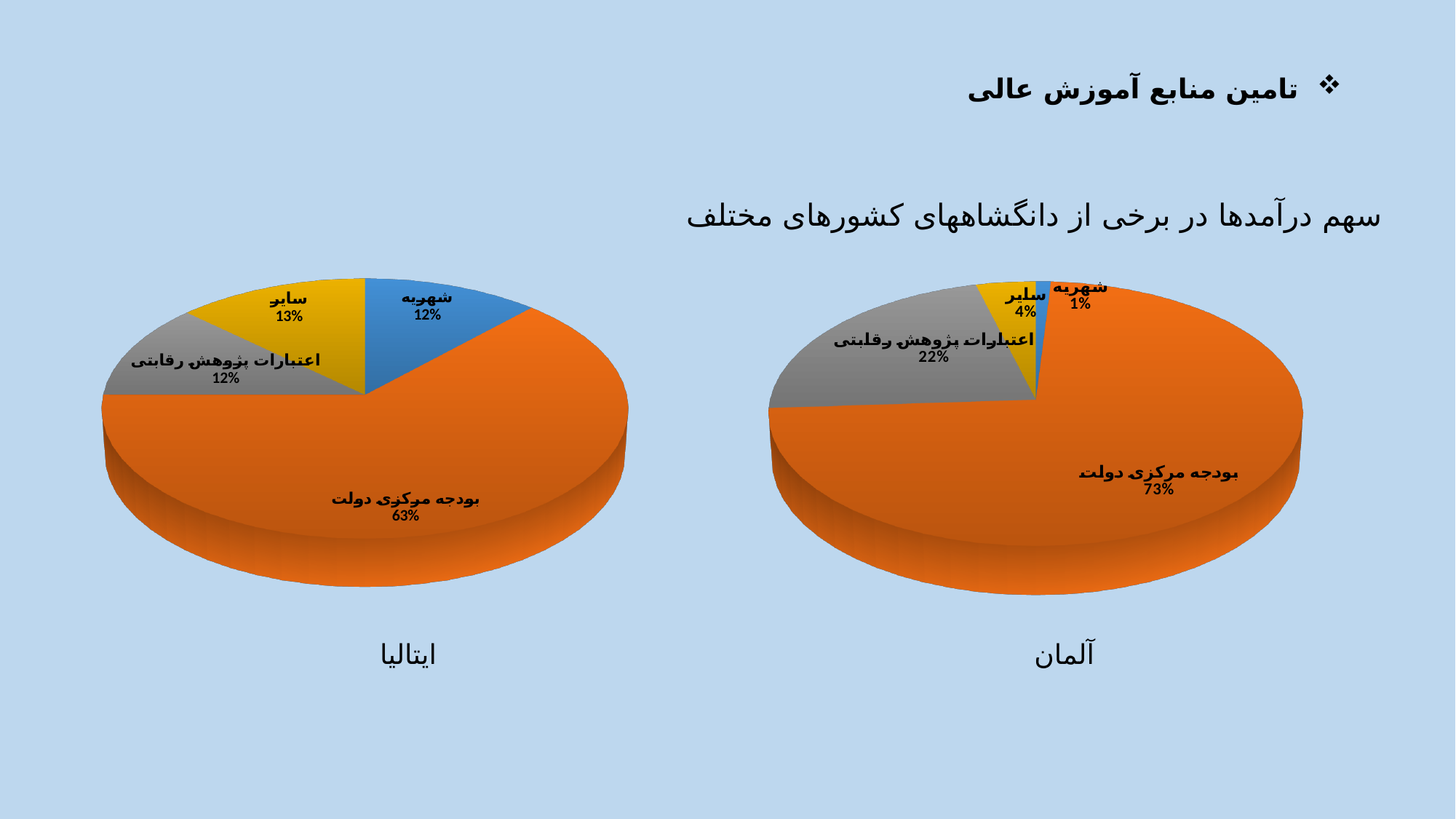
How many slices does the pie chart labelled ایتالیا (left) have? 4 What is the difference between the بودجه مرکزی دولت share in the آلمان chart and the بودجه مرکزی دولت share in the ایتالیا chart? 10% In the pie chart labelled آلمان (right), what share is shown for شهریه? 1% In the pie chart labelled ایتالیا (left), what share is shown for بودجه مرکزی دولت? 63% In the pie chart labelled ایتالیا (left), which category has the largest slice? بودجه مرکزی دولت In the pie chart labelled آلمان (right), which category has the largest slice? بودجه مرکزی دولت In the pie chart labelled ایتالیا (left), what colour is the slice for سایر? Yellow In the pie chart labelled ایتالیا (left), what share is shown for سایر? 13% What type of chart is used for the آلمان (right) chart? Pie chart In the pie chart labelled آلمان (right), what share is shown for اعتبارات پژوهش رقابتی? 22% Which chart shows a larger share for شهریه, the ایتالیا chart or the آلمان chart? ایتالیا In the pie chart labelled آلمان (right), which category has the smallest slice? شهریه